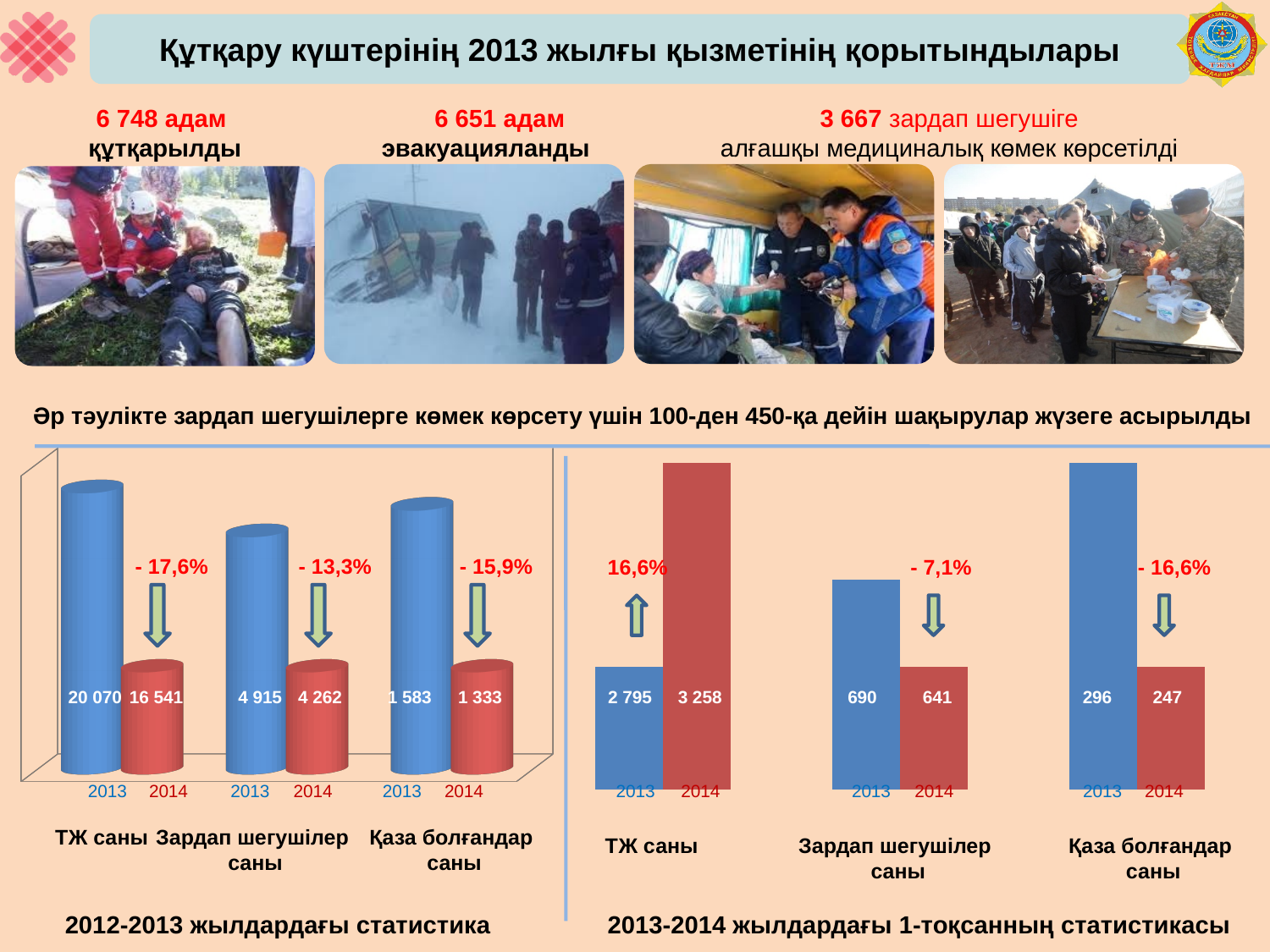
In the left chart (2012-2013 жылдардағы статистика), what percentage change is shown above the bars for ТЖ саны? - 17,6% How many categories are shown on the x axis of the left chart (2012-2013 жылдардағы статистика)? 3 In the right chart (2013-2014 жылдардағы 1-тоқсанның статистикасы), what is the difference between the 2013 and 2014 values for Қаза болғандар саны? 49 In the right chart (2013-2014 жылдардағы 1-тоқсанның статистикасы), what is the value of the 2013 bar for Зардап шегушілер саны? 690 In the right chart (2013-2014 жылдардағы 1-тоқсанның статистикасы), which is larger for ТЖ саны, the 2013 bar or the 2014 bar? 2014 In the left chart (2012-2013 жылдардағы статистика), what is the difference between the 2013 and 2014 values for Қаза болғандар саны? 250 What type of chart is the right chart (2013-2014 жылдардағы 1-тоқсанның статистикасы)? Bar chart In the left chart (2012-2013 жылдардағы статистика), what is the value of the 2014 bar for Зардап шегушілер саны? 4 262 In the right chart (2013-2014 жылдардағы 1-тоқсанның статистикасы), what percentage change is shown for Зардап шегушілер саны? - 7,1% In the left chart (2012-2013 жылдардағы статистика), what is the value of the 2014 bar for Қаза болғандар саны? 1 333 In the left chart (2012-2013 жылдардағы статистика), what is the value of the 2013 bar for ТЖ саны? 20 070 In the right chart (2013-2014 жылдардағы 1-тоқсанның статистикасы), what is the value of the 2014 bar for ТЖ саны? 3 258